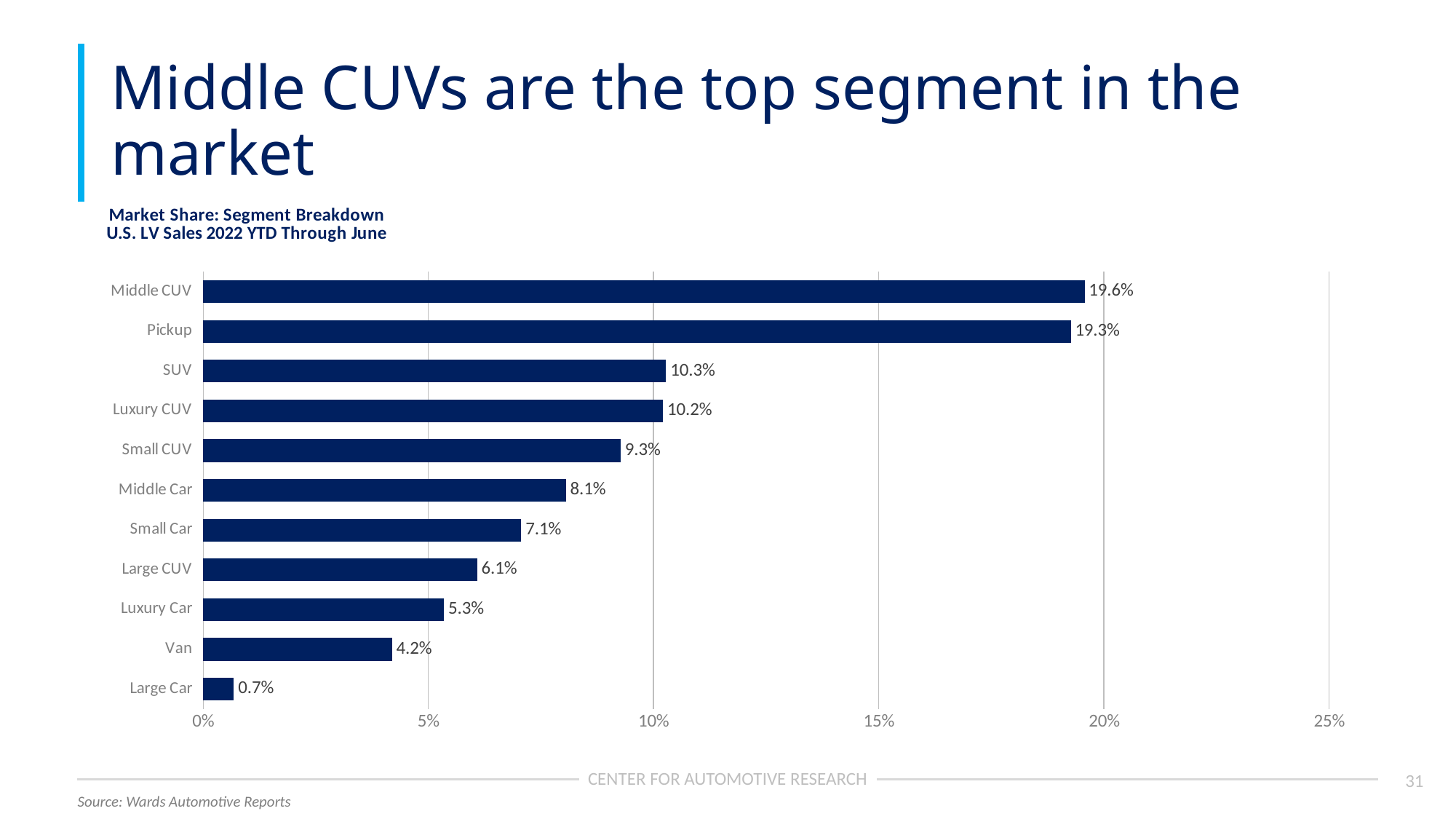
Is the value for Luxury Car greater or less than 5%? greater What is the market share for Small CUV? 9.3% Which has a larger market share, Middle Car or Large CUV? Middle Car How many segments are shown in the chart? 11 Which segment has the highest market share? Middle CUV What kind of chart is shown on the slide? Bar chart What is the market share for Van? 4.2% What is the title of the chart? Market Share: Segment Breakdown U.S. LV Sales 2022 YTD Through June Which segment has the lowest market share? Large Car What is the difference in market share between Middle CUV and Pickup? 0.3% What is the difference in market share between SUV and Small Car? 3.2% What is the market share for Pickup? 19.3%